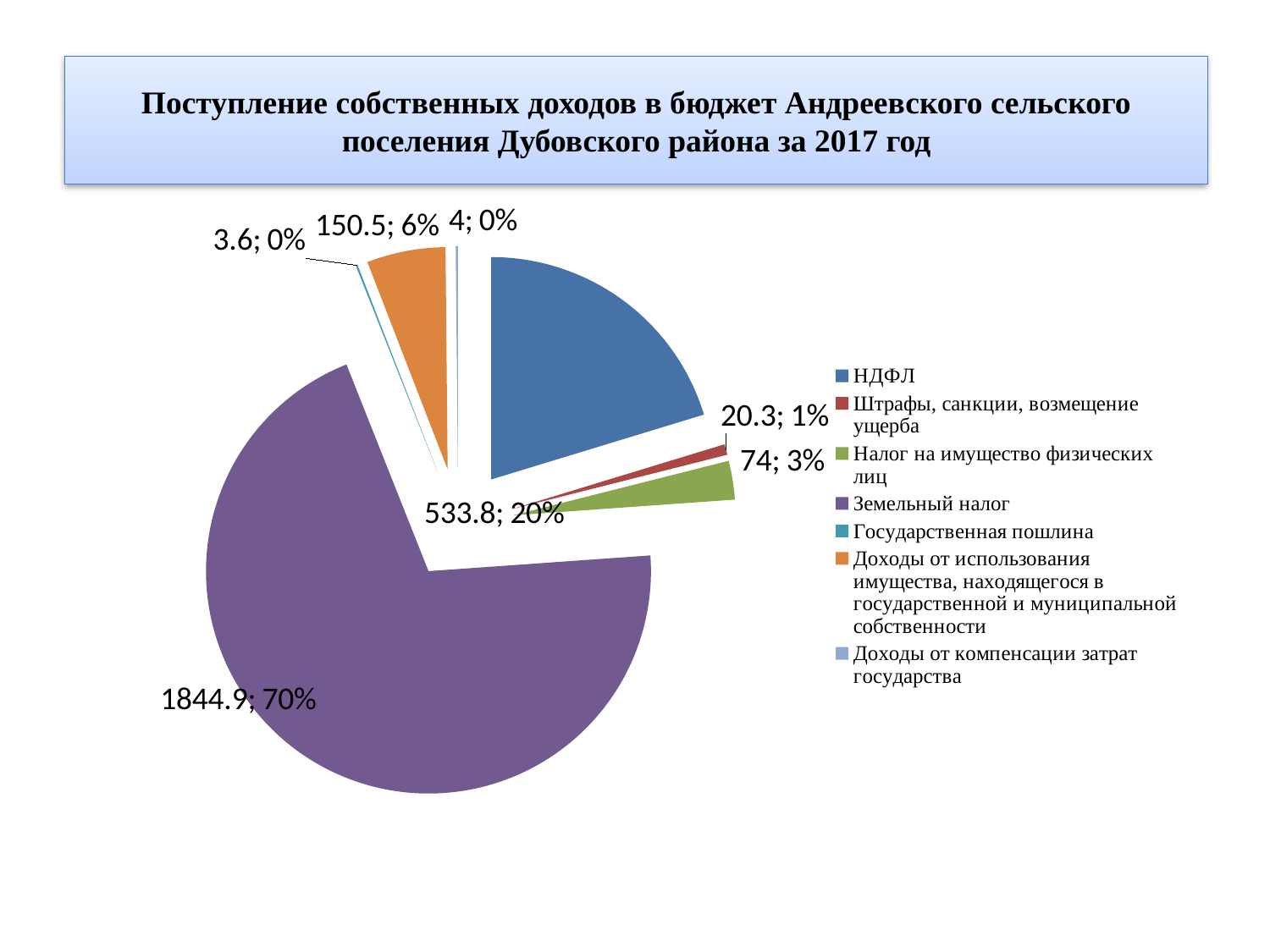
What is the value for Налог на имущество физических лиц? 74 Which category has the smallest slice of the pie? Государственная пошлина What is the value for НДФЛ? 533.8 What share of the pie does НДФЛ represent? 20% What is the difference between the values for Земельный налог and НДФЛ? 1311.1 What is the value for Земельный налог? 1844.9 What is the value for Государственная пошлина? 3.6 Which category has the largest slice of the pie? Земельный налог What type of chart is shown on the slide? pie chart How many categories does the legend list? 7 What share of the pie does Доходы от использования имущества, находящегося в государственной и муниципальной собственности represent? 6% What is the value for Штрафы, санкции, возмещение ущерба? 20.3